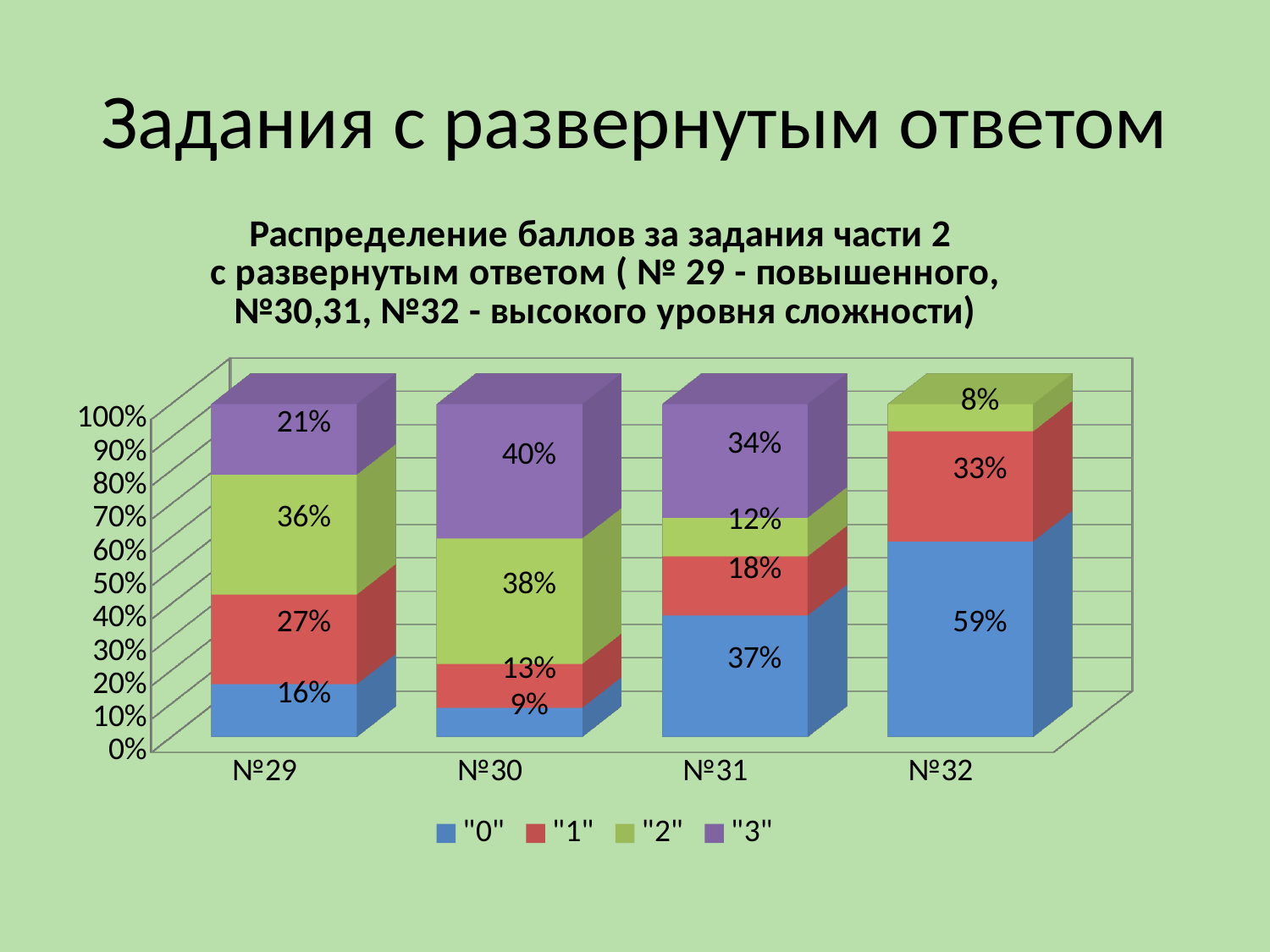
What is the value of series "3" for №30? 40% Which is larger: the "2" value for №30 or the "2" value for №31? №30 Which category has the lowest value for series "0"? №30 What kind of chart is shown on the slide? stacked bar chart How many series does the legend list? 4 Which category has the highest value for series "0"? №32 What is the value of series "2" for №29? 36% Which series is shown in purple in the legend? "3" How many task categories are shown on the x axis? 4 What is the difference between the "3" values for №30 and №29? 19% What is the value of series "1" for №31? 18% What is the value of series "0" for №32? 59%